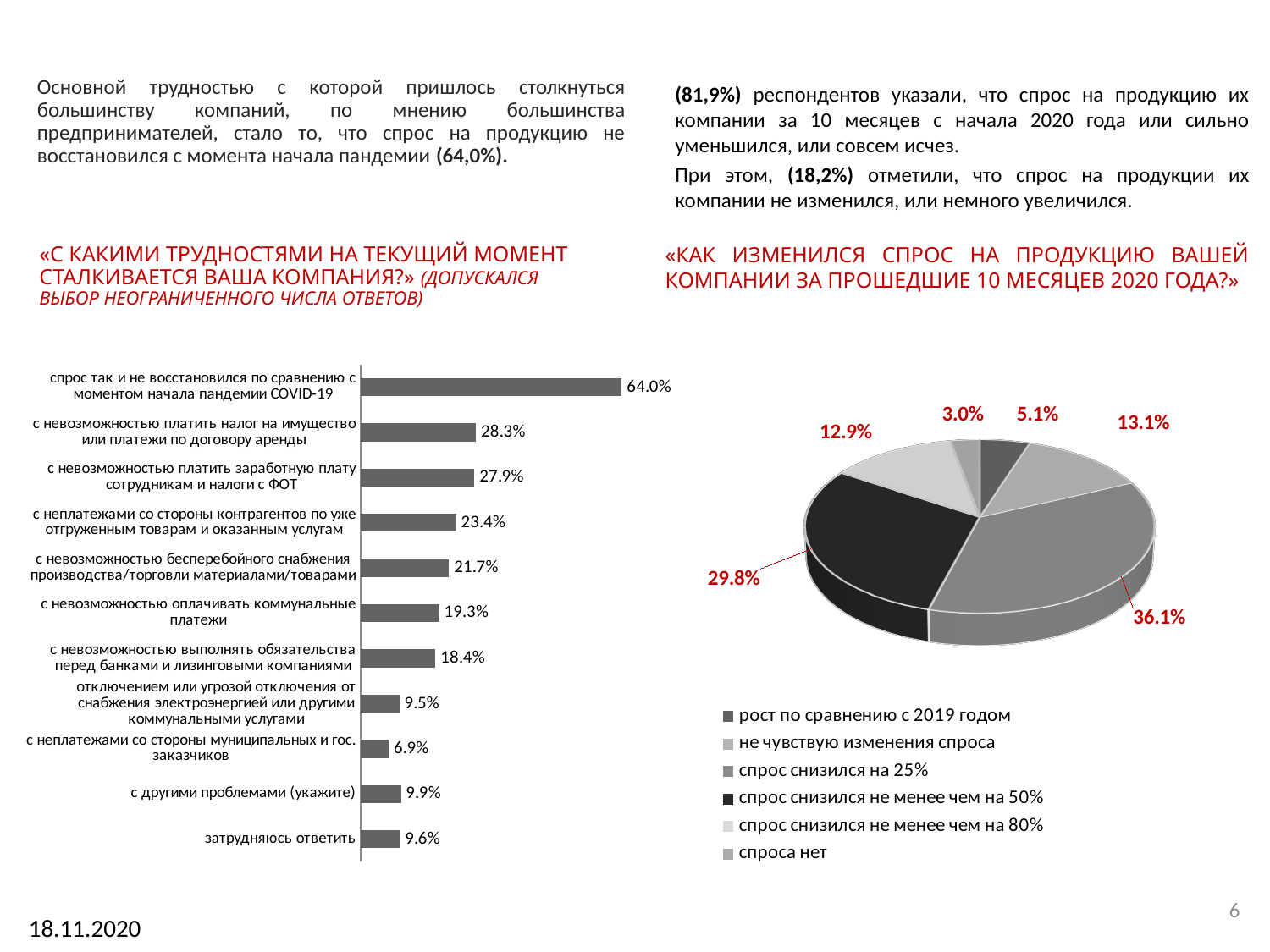
What type of chart is the chart on the left of the slide? bar chart How many entries does the legend of the right pie chart list? 6 On the right pie chart, what is the smallest slice's value? 3.0% On the left bar chart, which is larger: «с другими проблемами (укажите)» or «затрудняюсь ответить»? с другими проблемами (укажите) On the right pie chart, what share is labelled for «спрос снизился не менее чем на 50%»? 29.8% How many categories are shown on the left bar chart? 11 On the left bar chart, which category has the lowest value? с неплатежами со стороны муниципальных и гос. заказчиков On the left bar chart, what is the difference between «с невозможностью платить налог на имущество или платежи по договору аренды» and «с невозможностью платить заработную плату сотрудникам и налоги с ФОТ»? 0.4% What type of chart is the chart on the right of the slide? pie chart On the left bar chart, what is the value for «спрос так и не восстановился по сравнению с моментом начала пандемии COVID-19»? 64.0% On the right pie chart, what is the largest slice's value? 36.1% On the left bar chart, what is the value for «с невозможностью оплачивать коммунальные платежи»? 19.3%